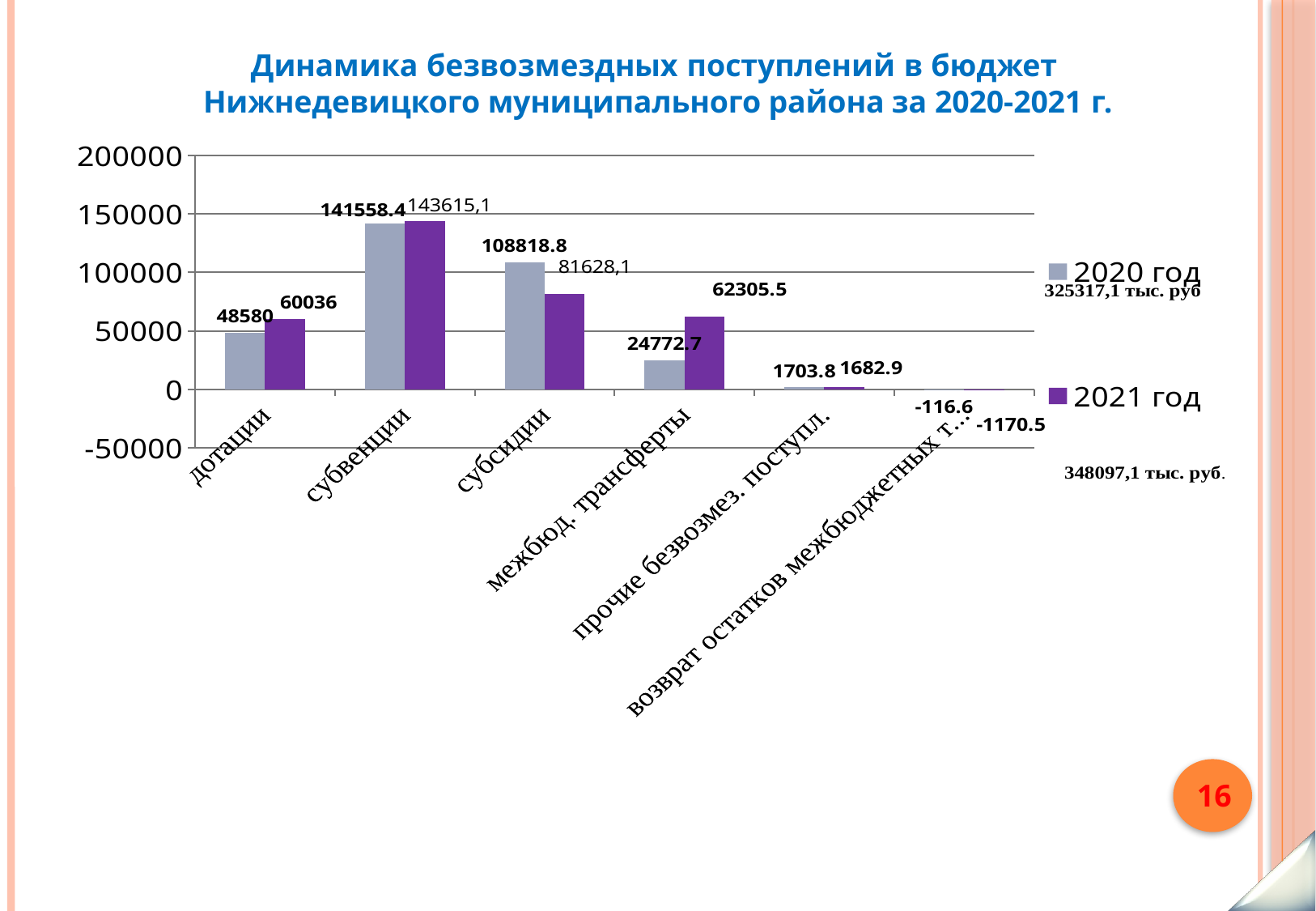
Which category has the highest value in the 2020 год series? субвенции What is the value for дотации in the 2020 год series? 48580 Is the 2020 год value for субсидии greater or less than 100000? greater How many categories are shown on the x axis of the chart? 6 Which category has the highest value in the 2021 год series? субвенции How many series does the legend list? 2 What is the value for прочие безвозмез. поступл. in the 2020 год series? 1703.8 What is the difference between the 2021 год and 2020 год values for дотации? 11456 What is the difference between the 2020 год and 2021 год values for межбюд. трансферты? 37532.8 For субсидии, which series has the larger value, 2020 год or 2021 год? 2020 год What is the value for субсидии in the 2021 год series? 81628,1 What is the value for межбюд. трансферты in the 2021 год series? 62305.5